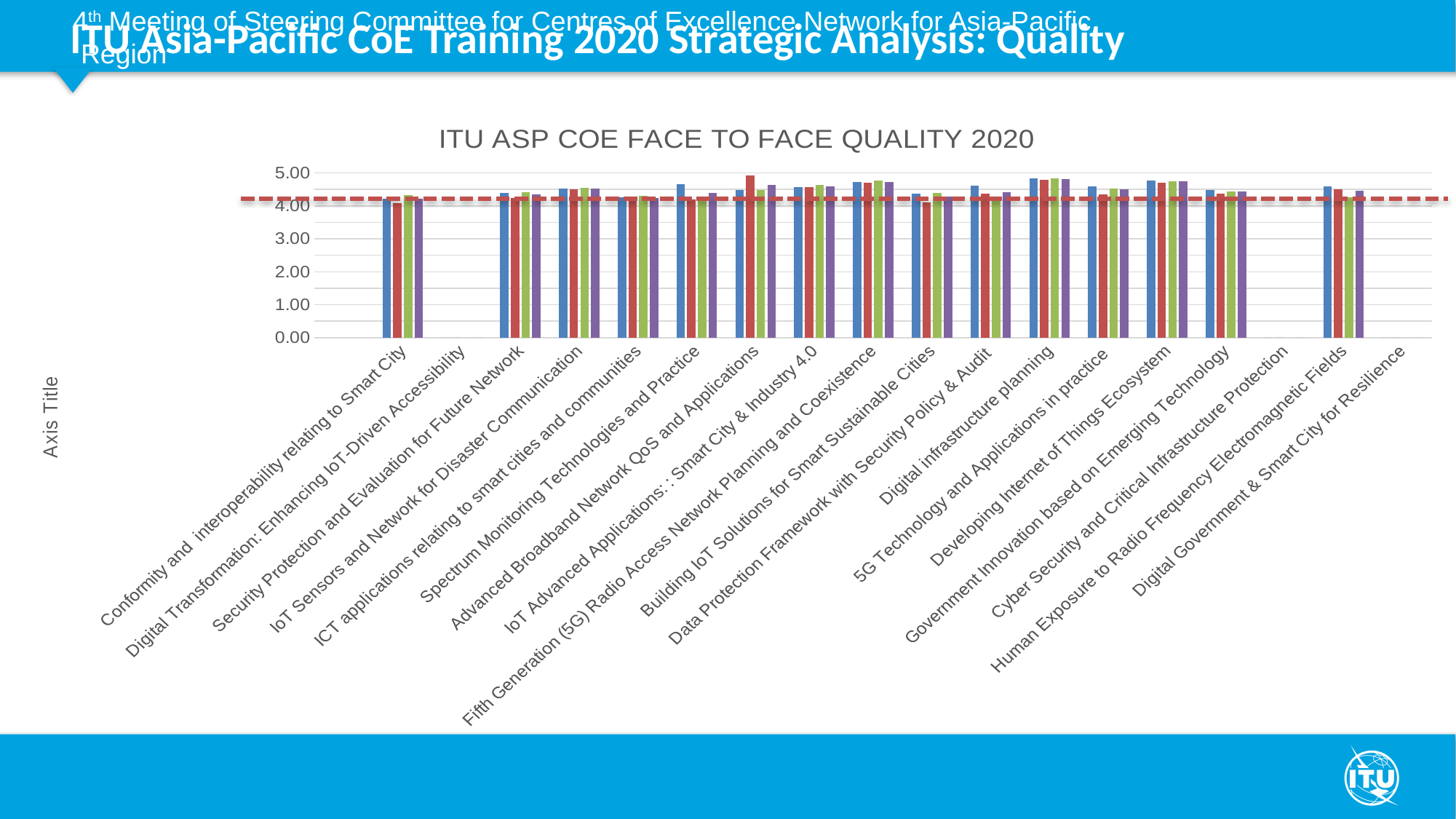
How many bars are plotted for the category 'Digital infrastructure planning'? 4 Is the first (blue) bar for 'Developing Internet of Things Ecosystem' greater or less than 3.00? greater What is the title of the chart? ITU ASP COE FACE TO FACE QUALITY 2020 Is the tallest bar for 'Advanced Broadband Network QoS and Applications' greater or less than 4.00? greater Which category contains the single tallest bar in the chart? Advanced Broadband Network QoS and Applications How many categories are listed along the x axis of the chart? 18 Is the dashed horizontal line on the chart above or below the 4.00 gridline? above What kind of chart is shown on the slide? Bar chart What is the highest value shown on the vertical axis of the chart? 5.00 Which is larger: the first (blue) bar for 'Digital infrastructure planning' or the first (blue) bar for 'Conformity and interoperability relating to Smart City'? Digital infrastructure planning Does the category 'Cyber Security and Critical Infrastructure Protection' have any bars plotted? No